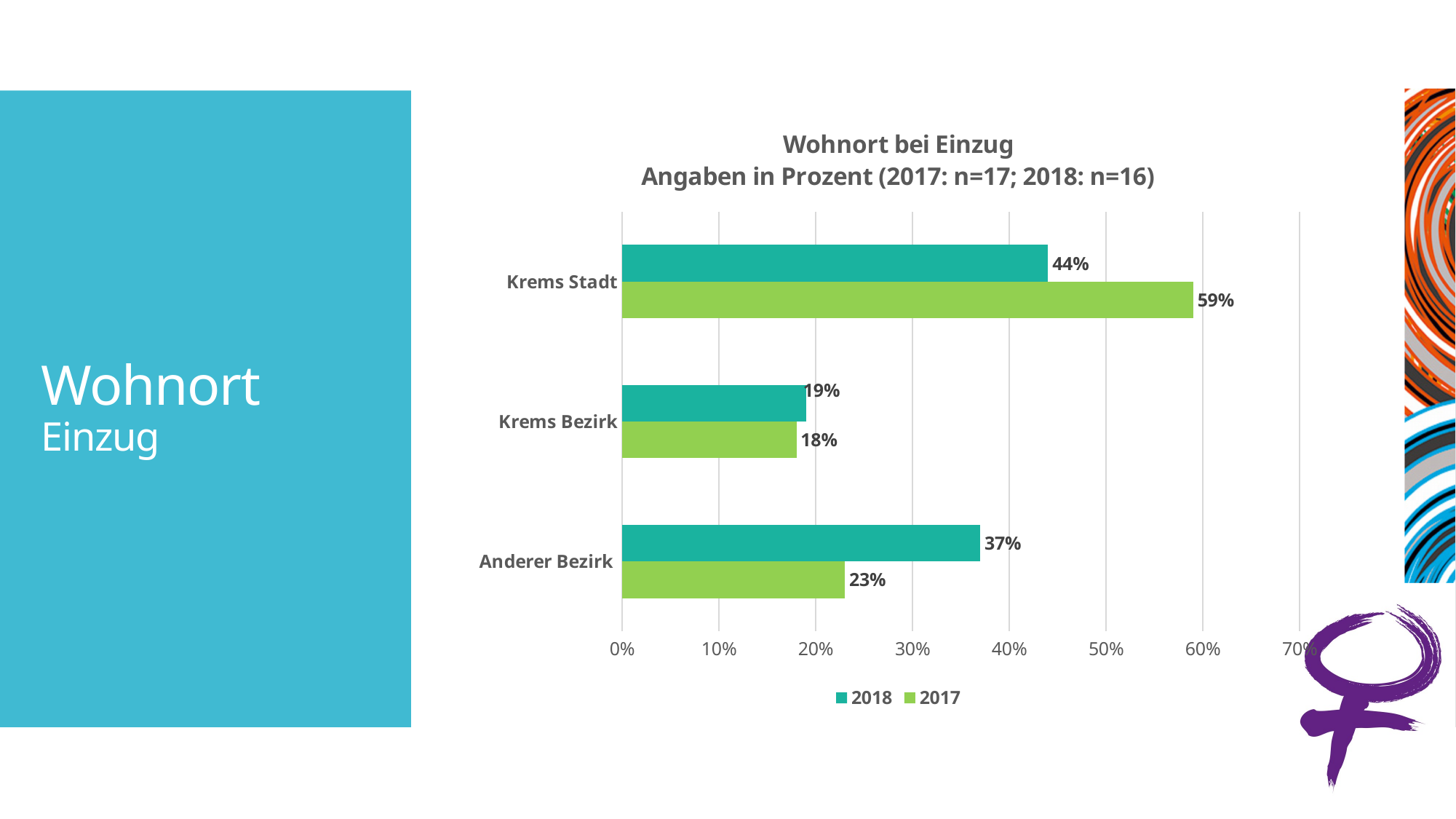
What is the 2018 value for Krems Stadt? 44% How many series does the legend list? 2 What is the difference between the 2018 and 2017 values for Anderer Bezirk? 14% What kind of chart is shown on the slide? Bar chart Which category has the highest 2017 value? Krems Stadt Which category has the lowest 2018 value? Krems Bezirk What is the difference between the 2017 and 2018 values for Krems Stadt? 15% What is the 2018 value for Anderer Bezirk? 37% What is the 2017 value for Krems Stadt? 59% How many categories are shown on the chart? 3 For Anderer Bezirk, which year has the larger value, 2017 or 2018? 2018 What is the 2017 value for Krems Bezirk? 18%